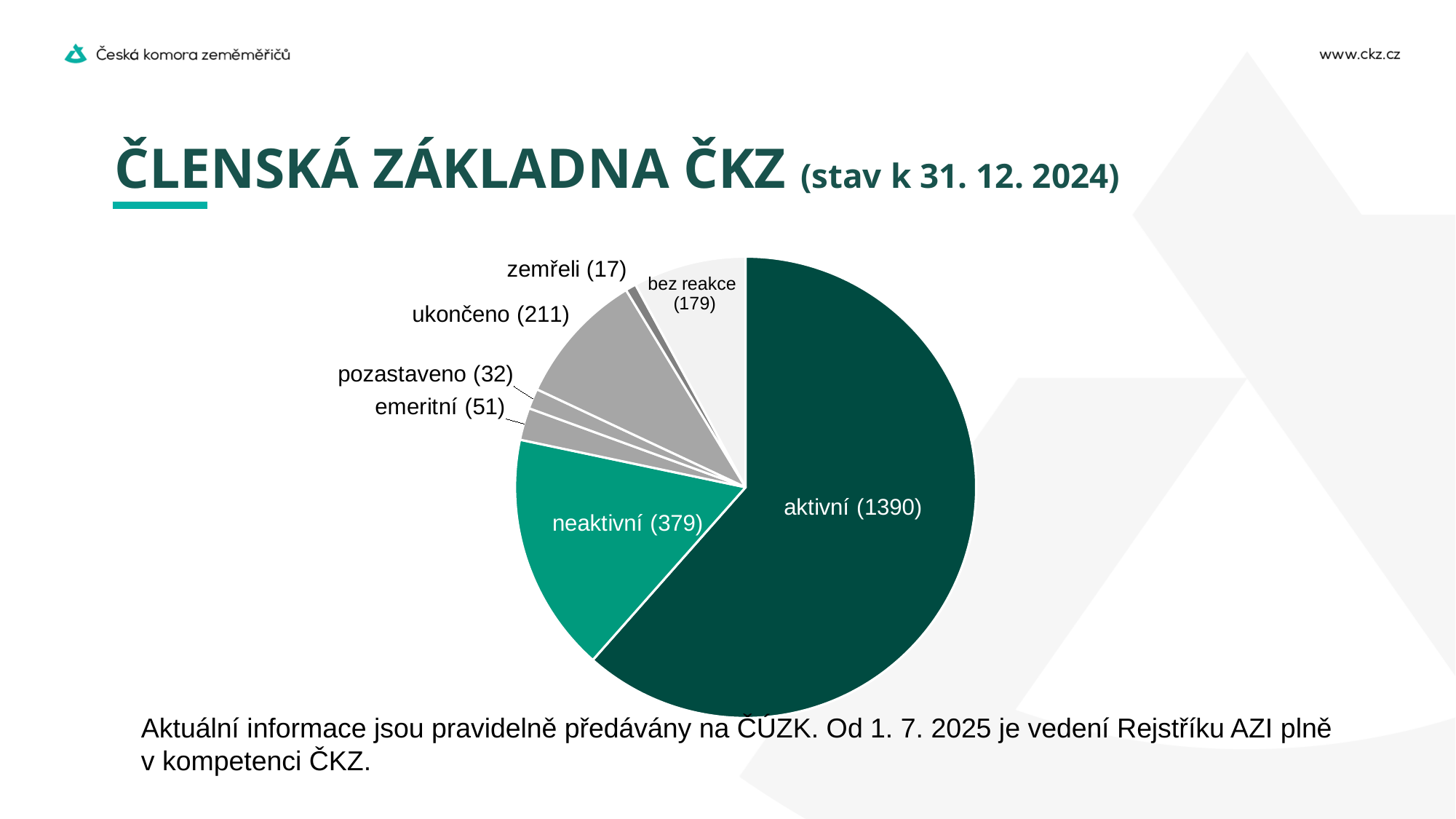
What is the total of all the values shown in the pie chart? 2259 What is the value shown for 'bez reakce'? 179 Which is larger, 'ukončeno' or 'bez reakce'? ukončeno Which category has the largest slice of the pie? aktivní Which category has the smallest slice of the pie? zemřeli What is the difference between the 'aktivní' and 'neaktivní' values? 1011 How many members are in the 'aktivní' category? 1390 What is the value for the 'neaktivní' slice? 379 How many categories (slices) does the pie chart have? 7 What is the value shown for 'ukončeno'? 211 What is the value shown for 'pozastaveno'? 32 What kind of chart is shown on the slide? pie chart